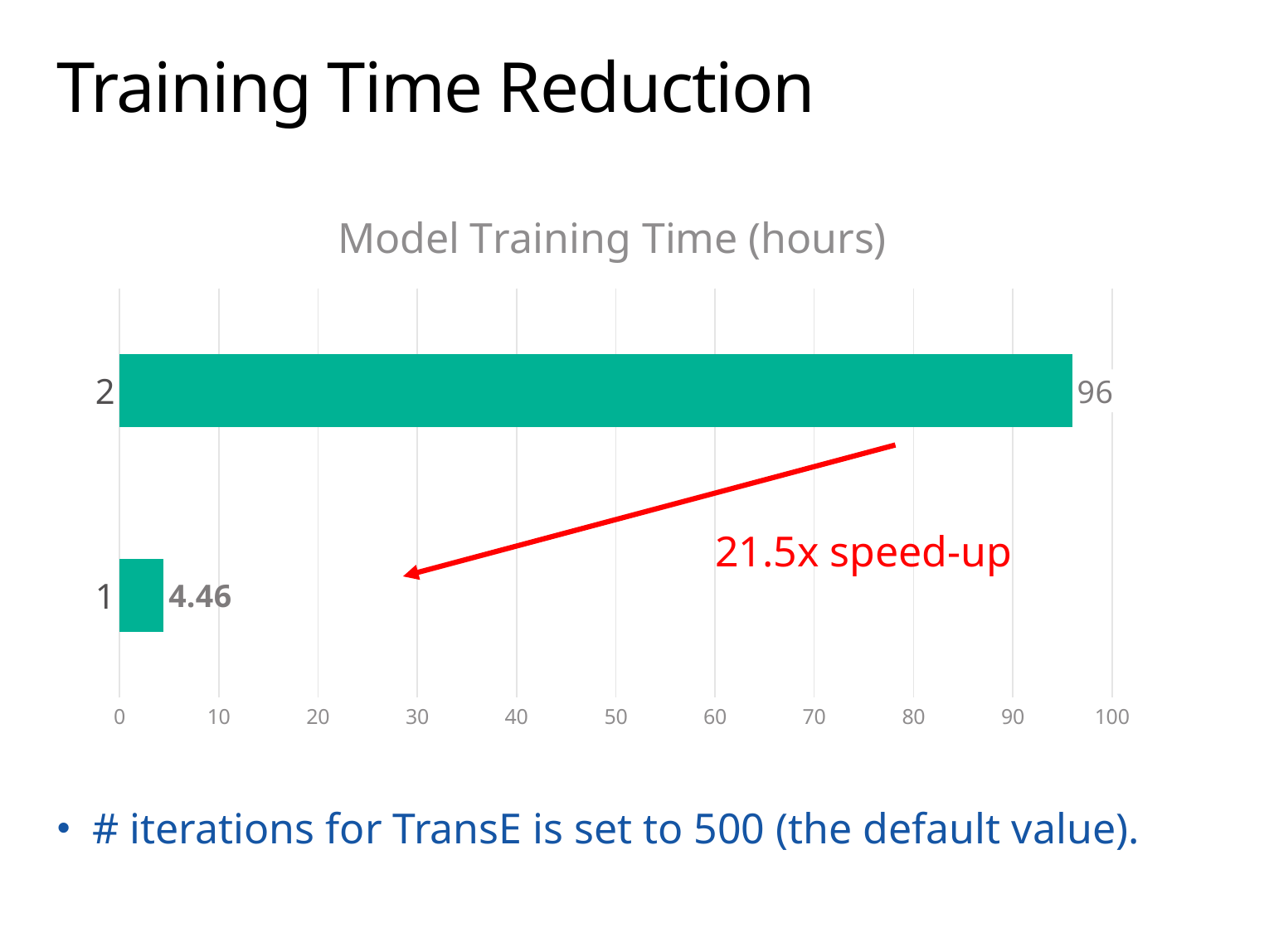
Is the value for category 1 greater or less than 10? less Which category has the lowest training time? 1 What is the title of the chart? Model Training Time (hours) What is the value for category 2 in the Model Training Time (hours) chart? 96 What speed-up does the red annotation on the chart state? 21.5x speed-up How many bars are plotted in the chart? 2 Is the value for category 2 greater or less than 90? greater Which category has the highest training time? 2 What is the difference between the training time for category 2 and category 1? 91.54 Which has a larger training time, category 1 or category 2? 2 What is the value for category 1 in the Model Training Time (hours) chart? 4.46 What kind of chart is shown on the slide? bar chart